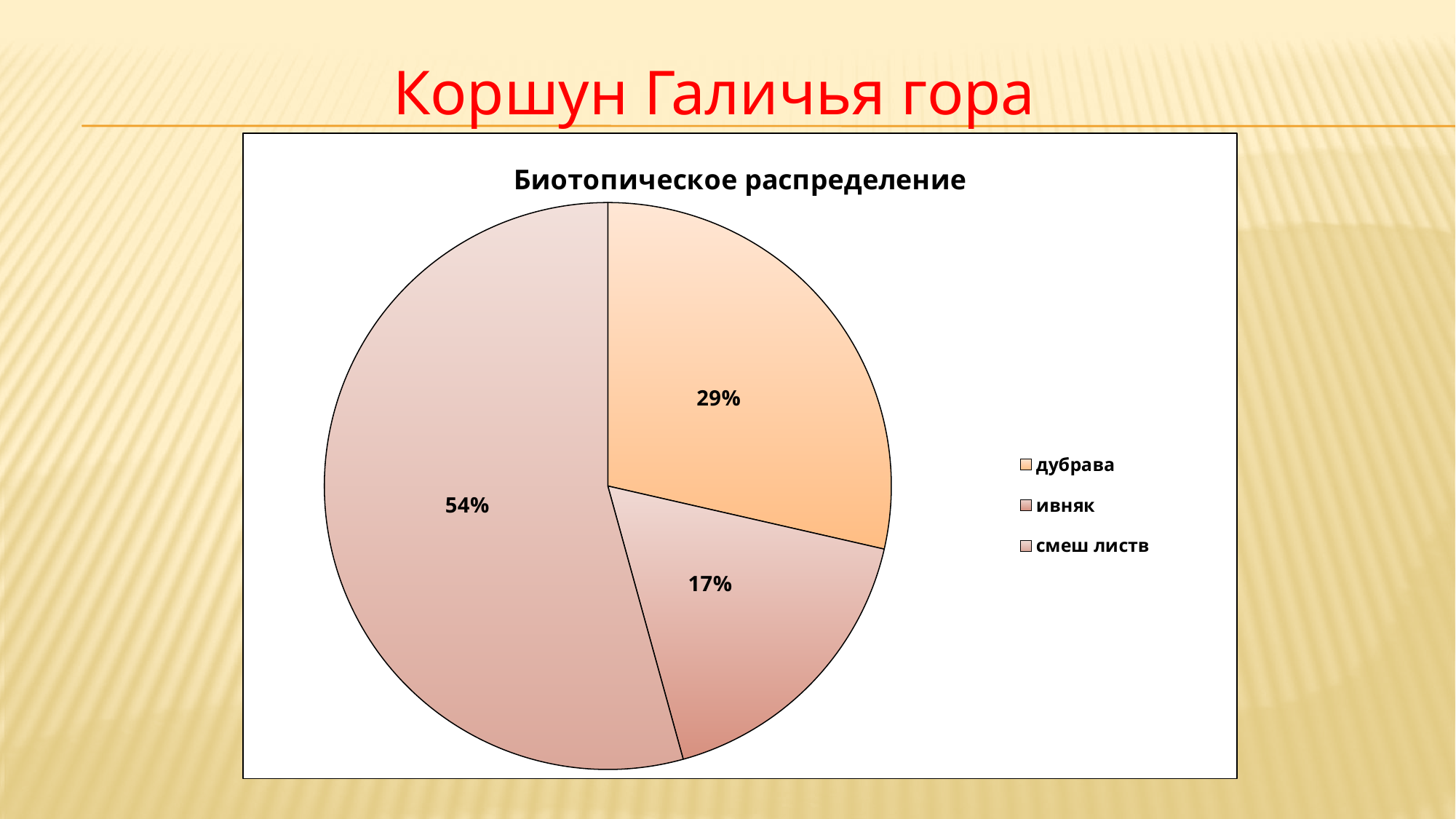
Which is larger, the share of дубрава or the share of ивняк? дубрава What share of the pie does дубрава have? 29% Which category has the largest share of the pie? смеш листв What share of the pie does ивняк have? 17% What share of the pie does смеш листв have? 54% What is the difference between the shares of дубрава and ивняк? 12% How many categories does the pie chart show? 3 What is the difference between the shares of смеш листв and дубрава? 25% What type of chart is shown on the slide? pie chart What is the title of the chart? Биотопическое распределение Which category has the smallest share of the pie? ивняк How many entries does the legend list? 3